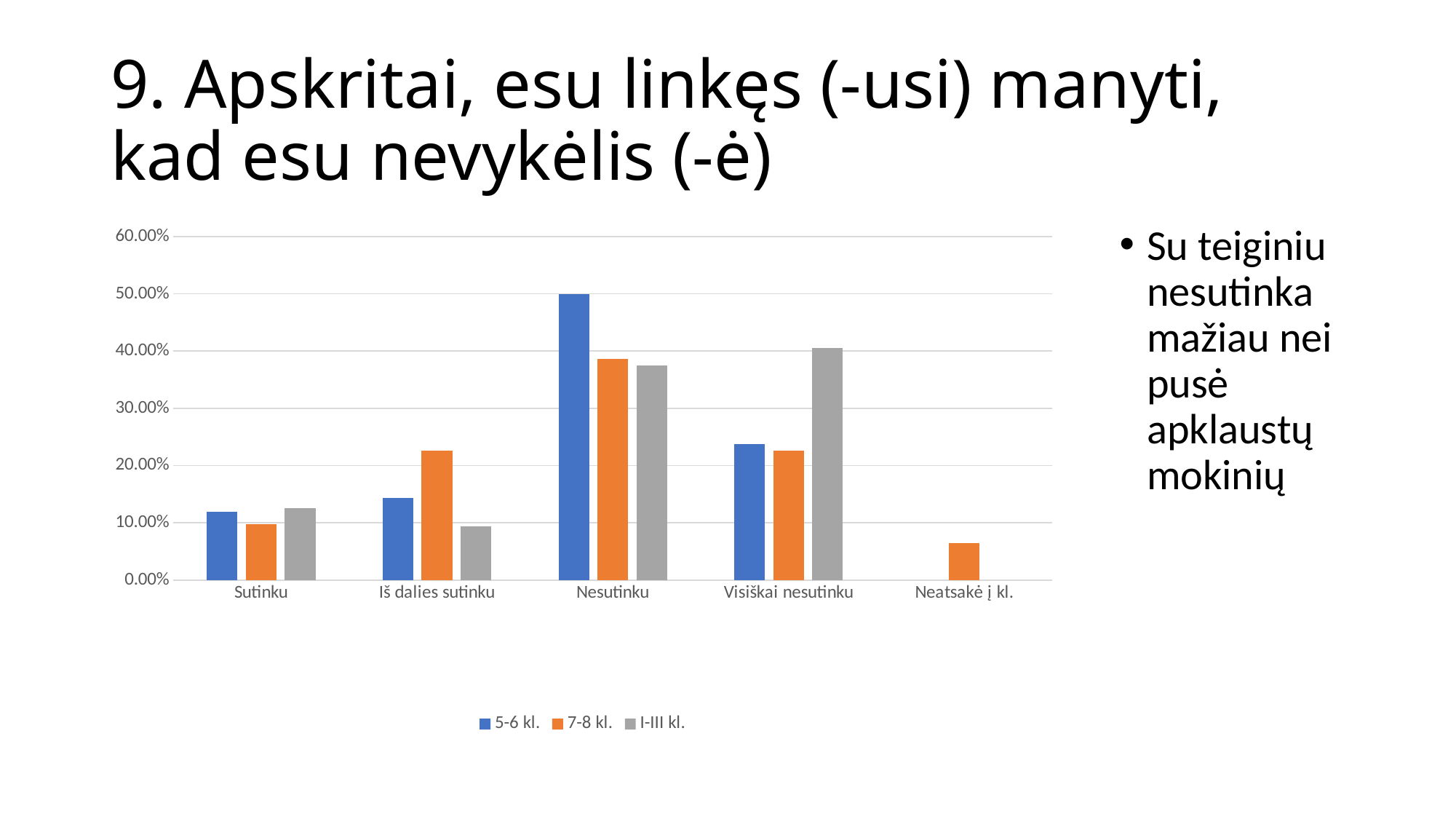
In the Iš dalies sutinku category, which series has the larger value: 7-8 kl. or I-III kl.? 7-8 kl. Is the value for 7-8 kl. in the Neatsakė į kl. category greater or less than 10.00%? less How many answer categories are shown on the x axis? 5 What is the value for 5-6 kl. in the Nesutinku category? 50.00% Which category has the highest value for the 5-6 kl. series? Nesutinku What kind of chart is shown on the slide? bar chart Which category has the highest value for the I-III kl. series? Visiškai nesutinku Which series is shown in orange in the legend? 7-8 kl. How many series does the legend list? 3 Is the value for I-III kl. in the Iš dalies sutinku category greater or less than 10.00%? less Which category has the lowest value for the 7-8 kl. series? Neatsakė į kl. Is the value for 7-8 kl. in the Nesutinku category greater or less than 30.00%? greater